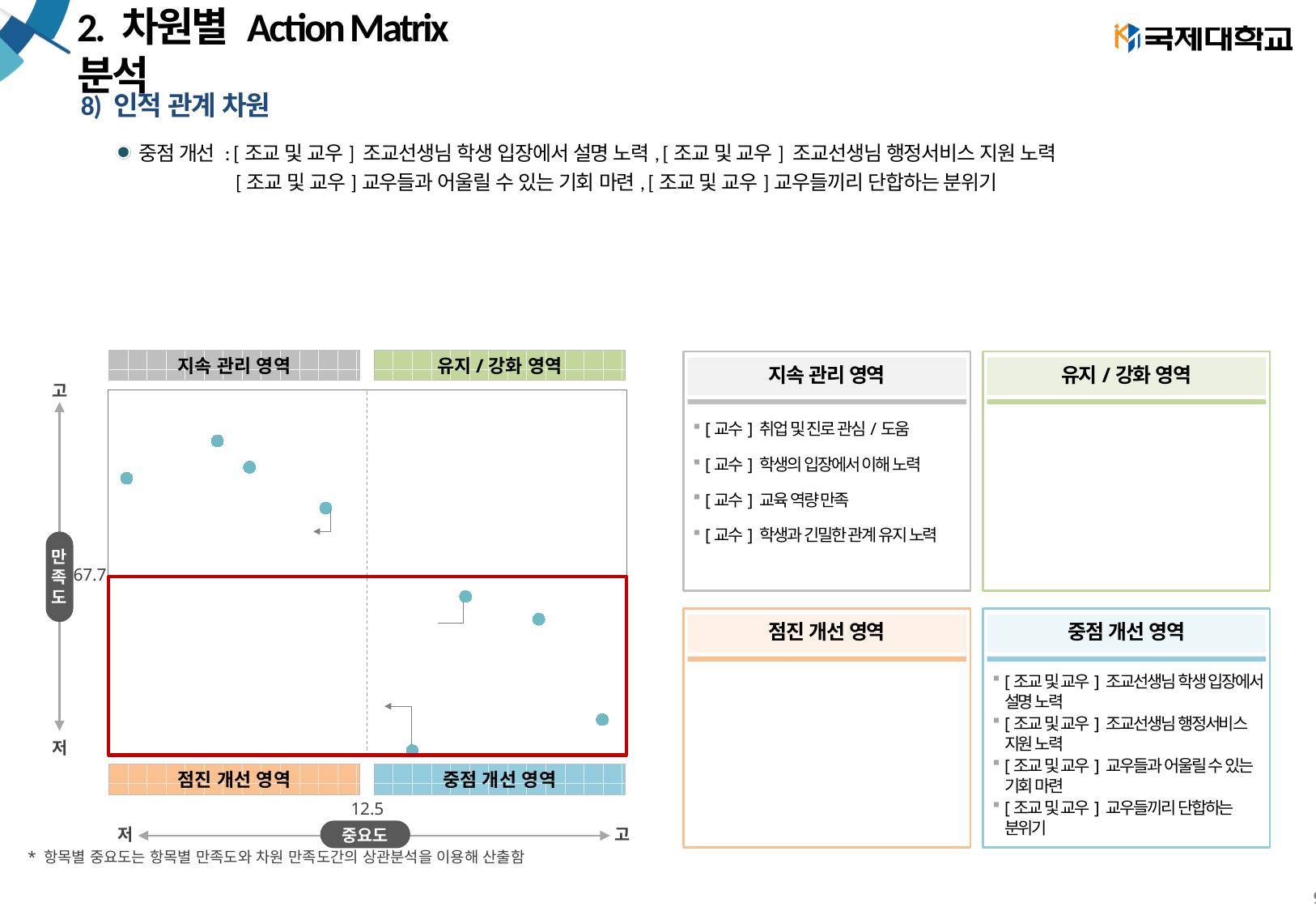
What is the label of the vertical axis of the chart? 만족도 How many points lie in the 유지 / 강화 영역 (upper-right) quadrant of the chart? 0 How many points lie in the 중점 개선 영역 (lower-right) quadrant of the chart? 4 What importance (중요도) value is marked by the vertical dashed reference line in the chart? 12.5 What satisfaction (만족도) value is marked by the horizontal reference line in the chart? 67.7 How many data points are plotted in the action matrix chart? 8 What kind of chart is shown on the left of the slide? scatter plot